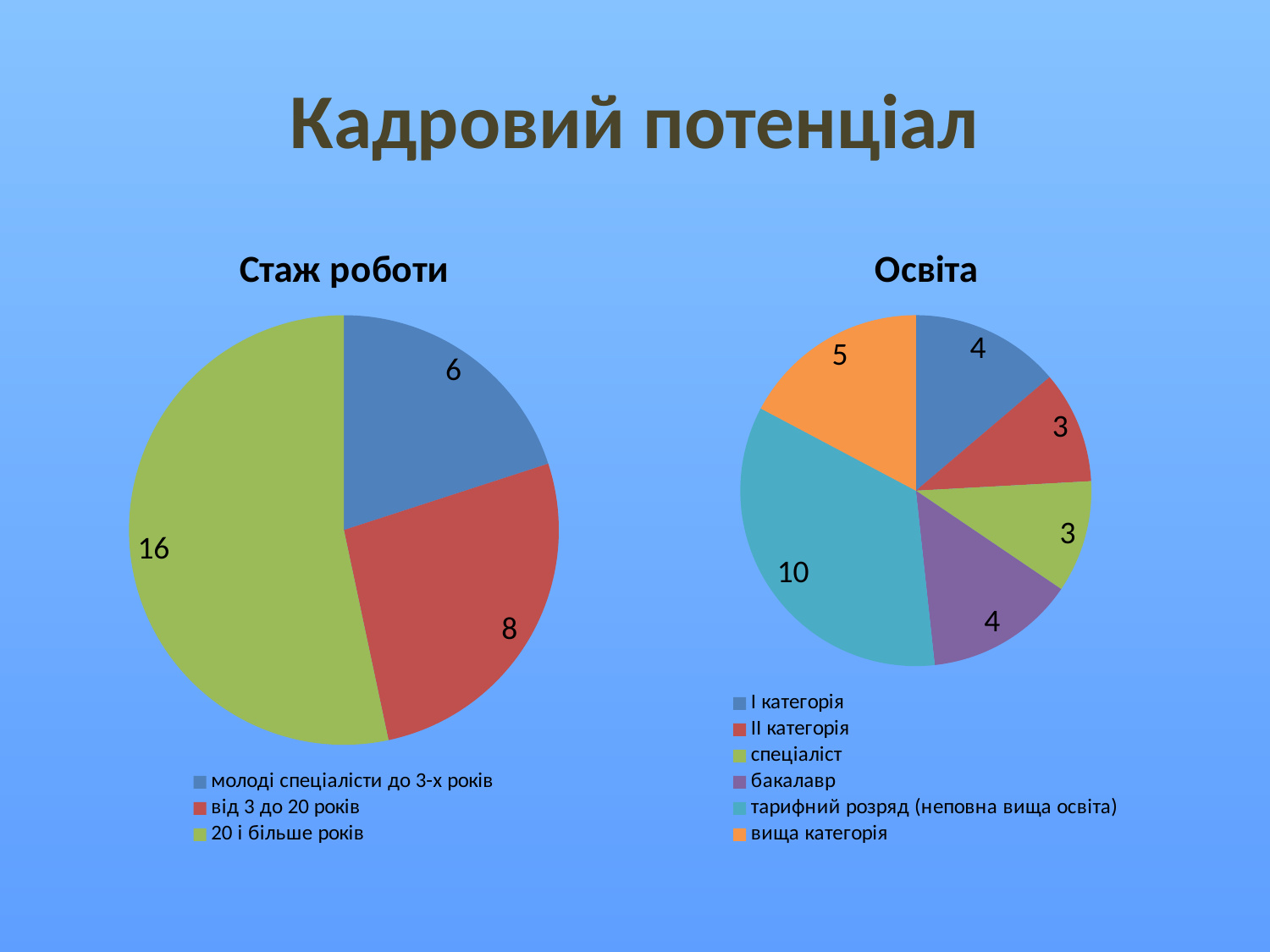
In the 'Освіта' chart, what is the value for 'тарифний розряд (неповна вища освіта)'? 10 In the 'Освіта' chart, what is the value for 'вища категорія'? 5 What type of chart is the 'Освіта' chart? pie chart In the 'Освіта' chart, which is larger: 'I категорія' or 'II категорія'? I категорія In the 'Стаж роботи' chart, which category has the largest slice? 20 і більше років How many entries does the legend of the 'Стаж роботи' chart list? 3 In the 'Стаж роботи' chart, what is the difference between '20 і більше років' and 'від 3 до 20 років'? 8 In the 'Стаж роботи' chart, what is the value for 'молоді спеціалісти до 3-х років'? 6 In the 'Стаж роботи' chart, what is the value for '20 і більше років'? 16 In the 'Освіта' chart, which category has the largest slice? тарифний розряд (неповна вища освіта) How many categories does the 'Освіта' chart show? 6 In the 'Стаж роботи' chart, what share of the total does 'молоді спеціалісти до 3-х років' represent? 20%